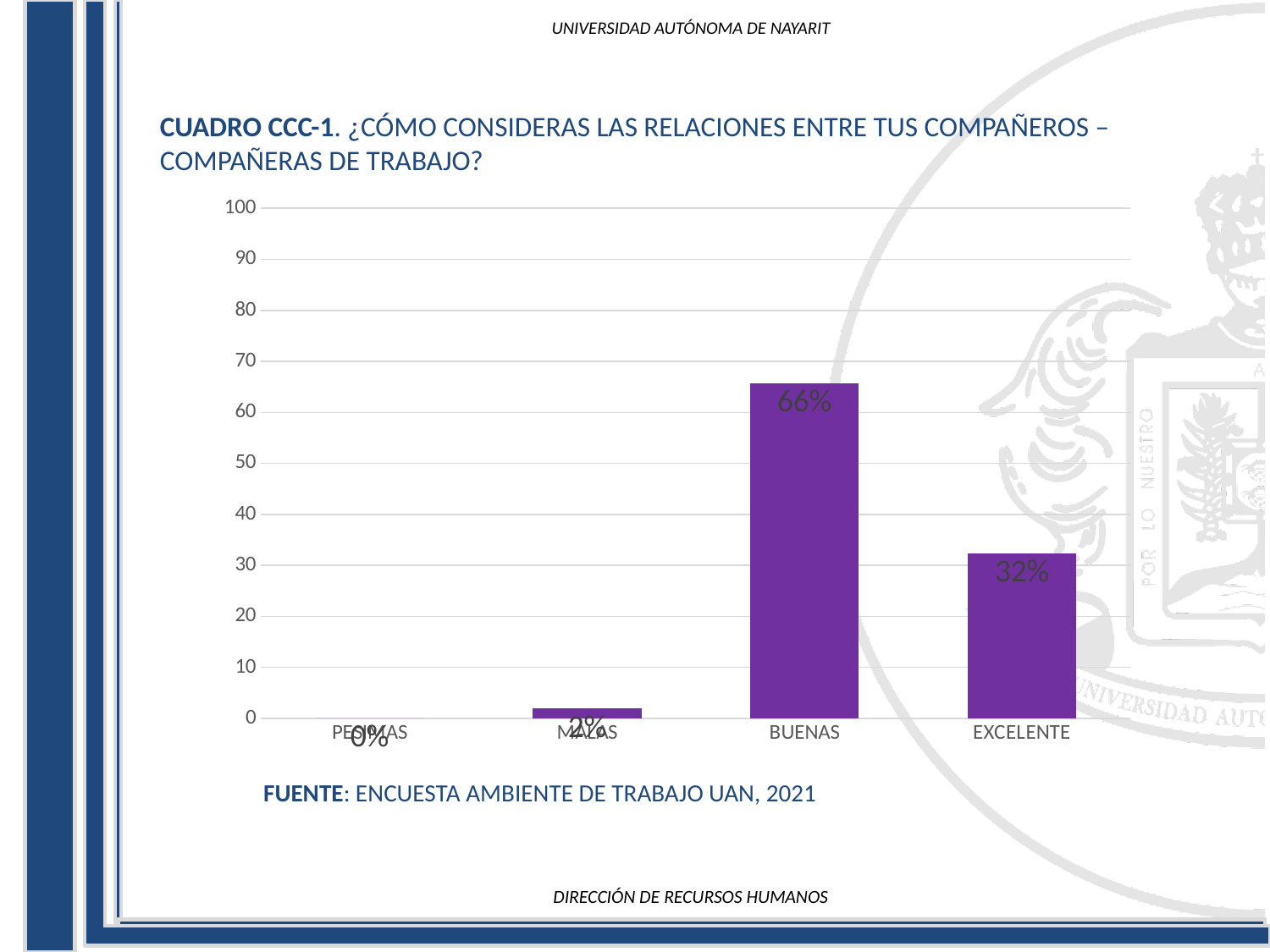
What kind of chart is shown on the slide? bar chart Which category has the lowest value? PÉSIMAS Is the value for BUENAS greater or less than 60? greater What is the value for PÉSIMAS? 0% What is the value for MALAS? 2% What source is cited below the chart? ENCUESTA AMBIENTE DE TRABAJO UAN, 2021 Which is larger, the value for EXCELENTE or the value for MALAS? EXCELENTE Which category has the highest value? BUENAS How many categories are shown on the x axis? 4 What is the value for EXCELENTE? 32% What is the difference between the values for BUENAS and EXCELENTE? 34% What is the value for BUENAS? 66%